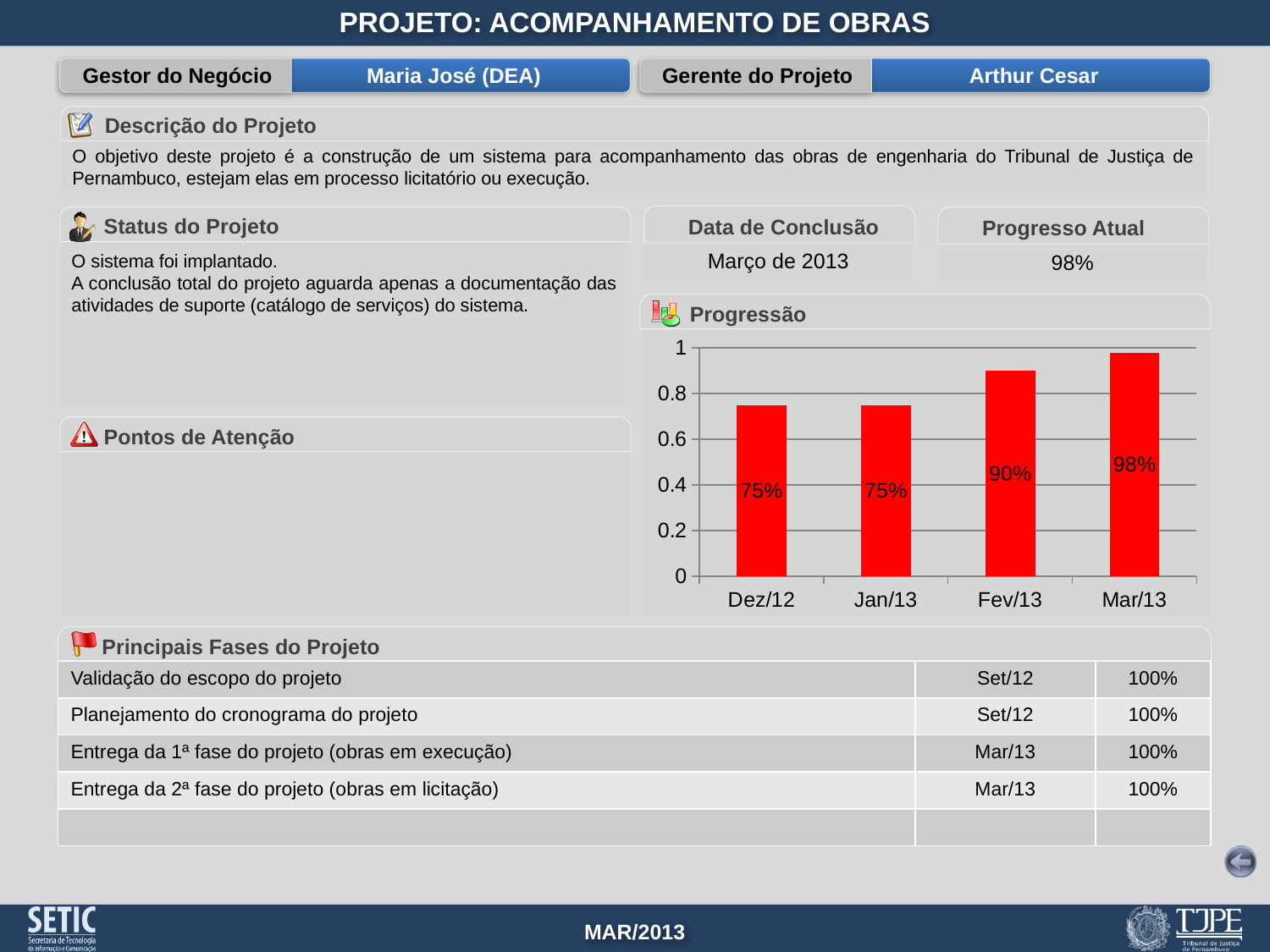
What is the value for Mar/13 in the Progressão chart? 98% Do the values in the Progressão chart rise or fall from Dez/12 to Mar/13? rise What is the difference between the values for Mar/13 and Fev/13 in the Progressão chart? 8% What is the value for Fev/13 in the Progressão chart? 90% What is the value for Dez/12 in the Progressão chart? 75% What kind of chart is the Progressão chart? bar chart How many months are shown on the x axis of the Progressão chart? 4 What is the difference between the values for Fev/13 and Jan/13 in the Progressão chart? 15% Which month has the highest value in the Progressão chart? Mar/13 Which is larger in the Progressão chart, the value for Fev/13 or the value for Jan/13? Fev/13 Is the value for Fev/13 in the Progressão chart greater or less than 0.8? greater Is the value for Dez/12 in the Progressão chart greater or less than 0.8? less